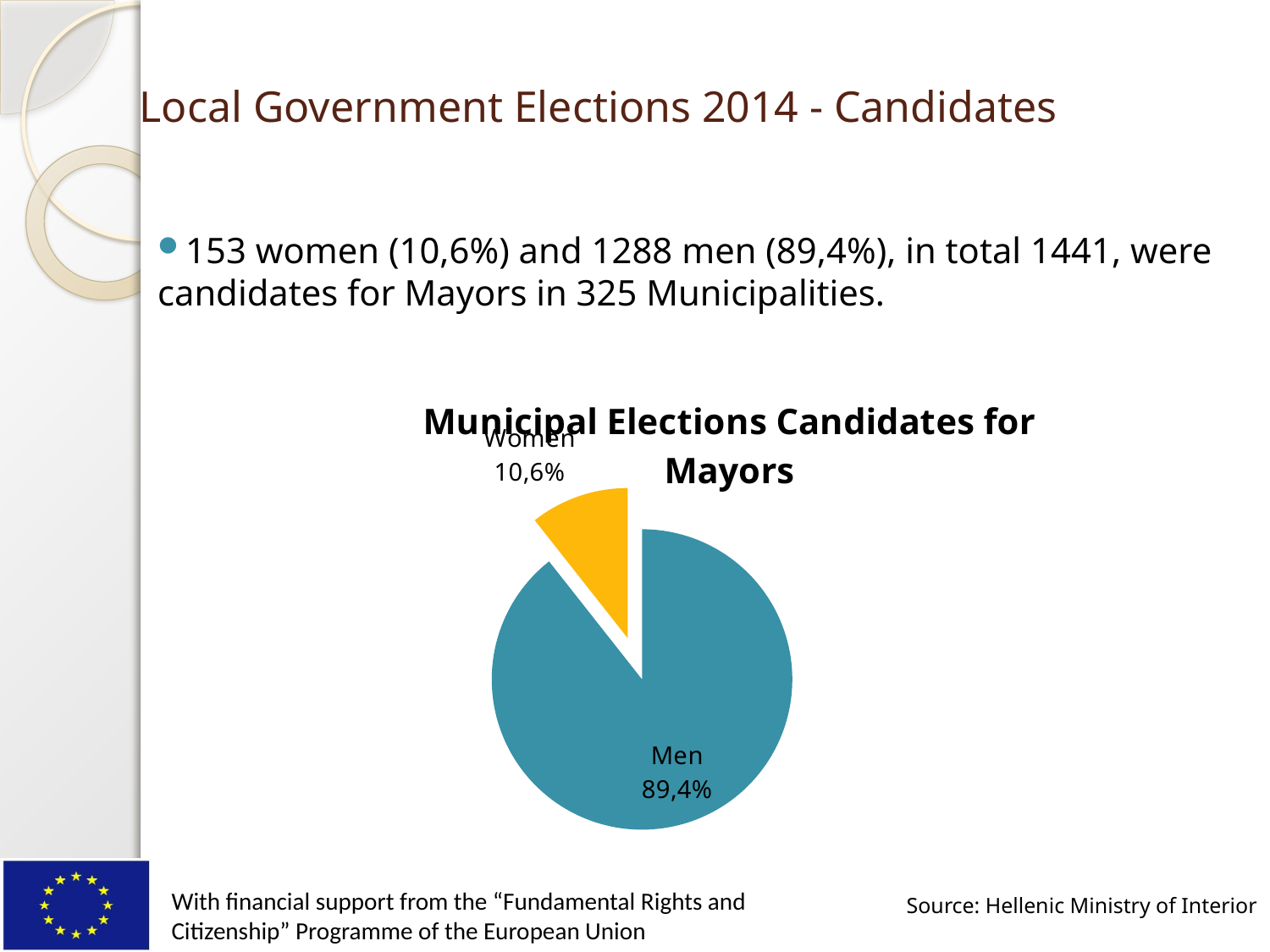
What share of the pie does the Women slice represent? 10,6% What is the difference in percentage points between the Men and Women slices? 78,8 How many slices does the pie chart have? 2 Which slice of the pie is the smallest? Women What share of the pie does the Men slice represent? 89,4% What type of chart is shown on the slide? pie chart What is the title of the chart? Municipal Elections Candidates for Mayors Is the share for Women greater or less than 50%? less Which is larger, the Men slice or the Women slice? Men What colour is the Women slice of the pie? yellow Which slice of the pie is the largest? Men